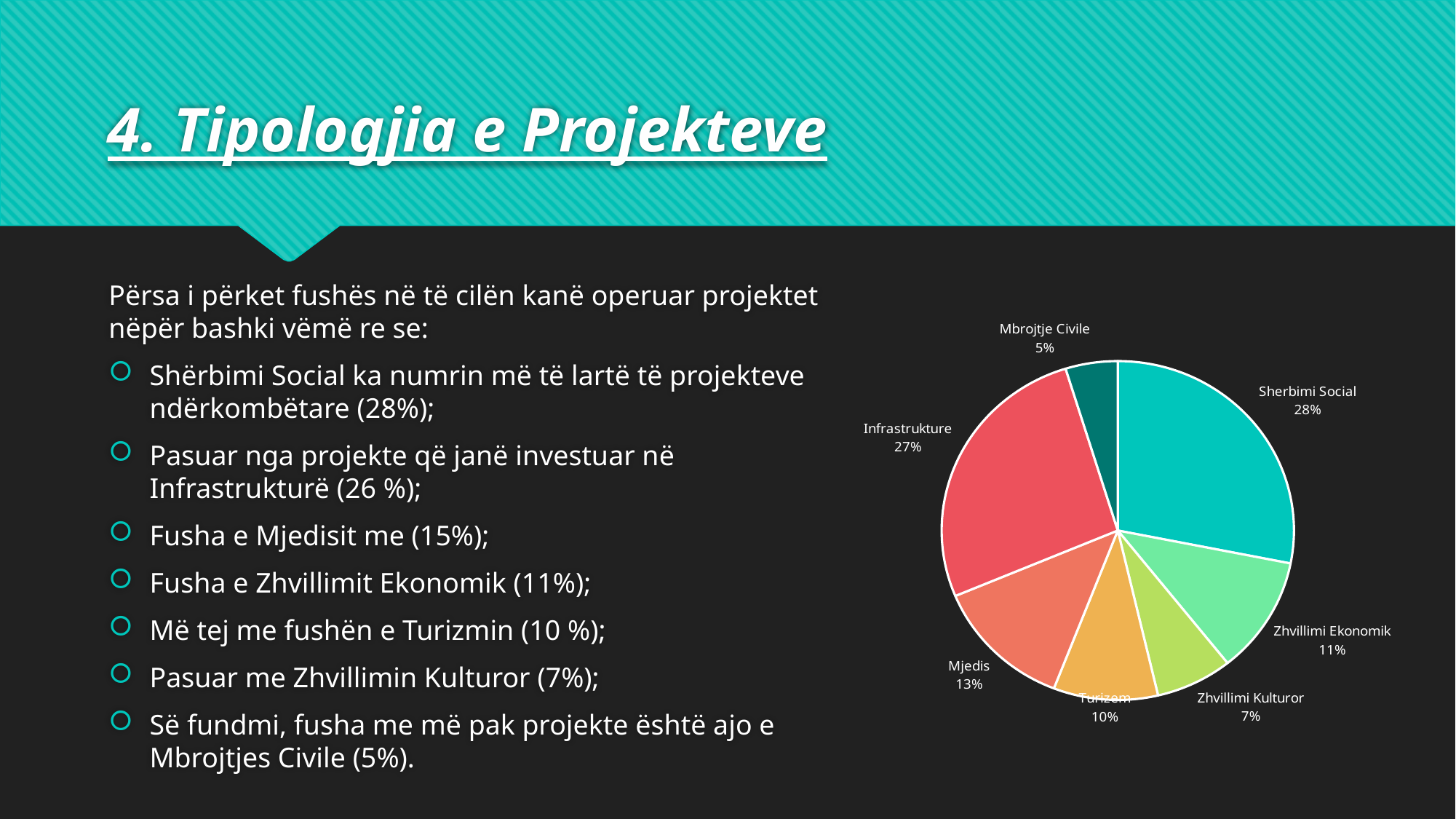
What kind of chart is shown on the slide? pie chart Which is larger in the pie chart, Zhvillimi Ekonomik or Turizem? Zhvillimi Ekonomik What percentage is shown for Infrastrukture in the pie chart? 27% What is the difference in percentage points between Sherbimi Social and Mbrojtje Civile? 23 What percentage is shown for Mjedis in the pie chart? 13% Which category has the largest slice of the pie chart? Sherbimi Social What percentage is shown for Turizem in the pie chart? 10% What share of the pie does Sherbimi Social have? 28% Which category has the smallest slice of the pie chart? Mbrojtje Civile What is the difference in percentage points between Mjedis and Zhvillimi Kulturor? 6 How many slices does the pie chart have? 7 What percentage is shown for Zhvillimi Kulturor in the pie chart? 7%